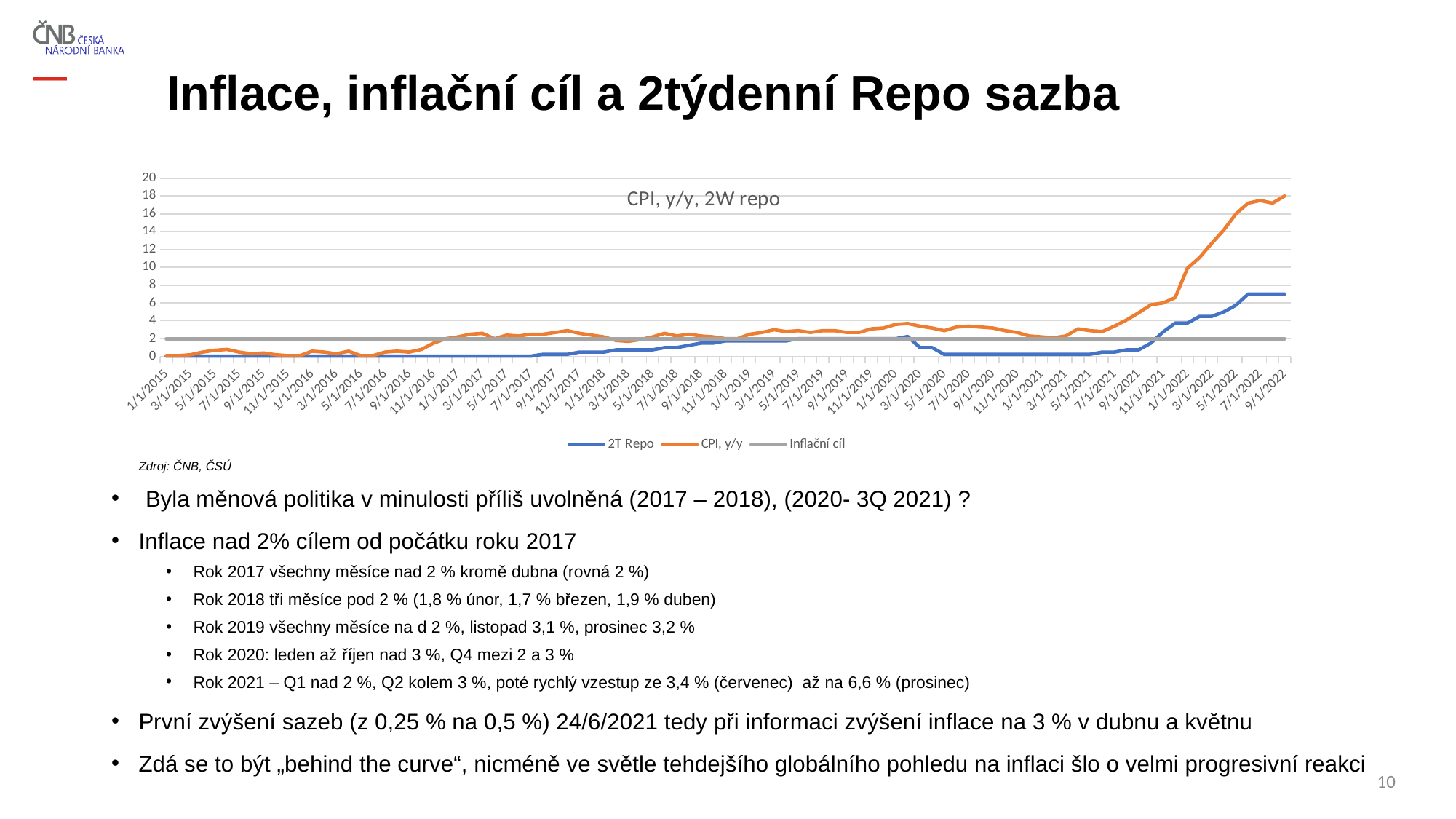
What kind of chart is shown on the slide? line chart Is the 2T Repo value at 9/1/2022 greater or less than 6? greater At what value does the flat Inflační cíl line sit on the y axis? 2 Is the 2T Repo value at 1/1/2016 greater or less than 2? less How many series does the chart legend list? 3 What is the title printed inside the chart area? CPI, y/y, 2W repo Does the CPI, y/y series rise or fall between 1/1/2021 and 9/1/2022? rise What are the three series listed in the chart legend? 2T Repo, CPI, y/y, Inflační cíl Is the CPI, y/y value at 5/1/2022 greater or less than 14? greater Which series reaches the highest value anywhere on the chart? CPI, y/y At 9/1/2022, which series is higher: CPI, y/y or 2T Repo? CPI, y/y